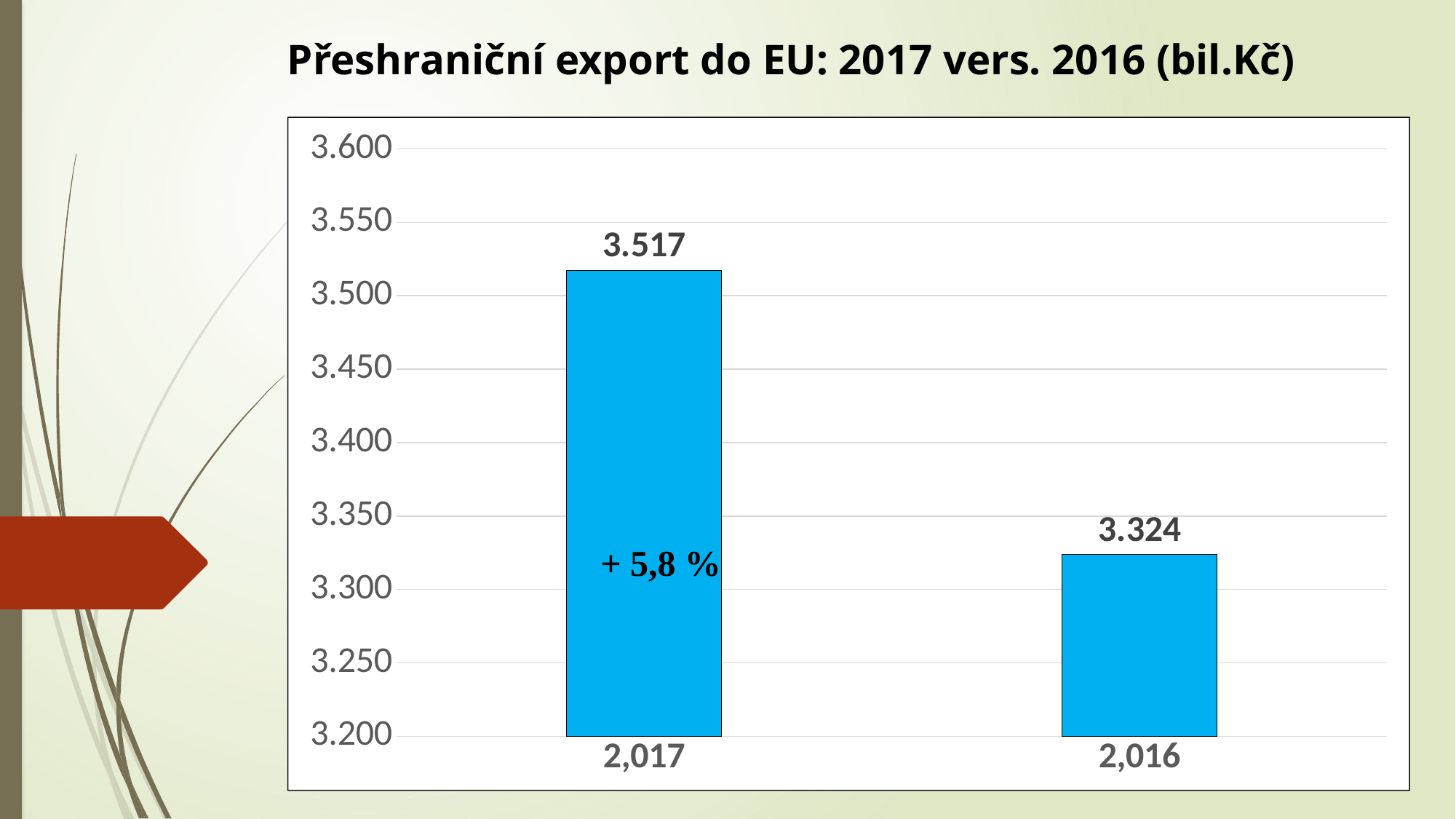
Is the value for 2016 greater or less than 3.350? less What percentage change is annotated on the 2017 bar? + 5,8 % What is the value for 2016? 3.324 What is the value for 2017? 3.517 What is the difference between the values for 2017 and 2016? 193 What is the title of the chart? Přeshraniční export do EU: 2017 vers. 2016 (bil.Kč) Which year has the higher value? 2017 Is the value for 2017 greater or less than 3.500? greater Which year has the lower value? 2016 Is the value for 2017 larger or smaller than the value for 2016? larger What kind of chart is shown on the slide? bar chart How many bars are shown in the chart? 2